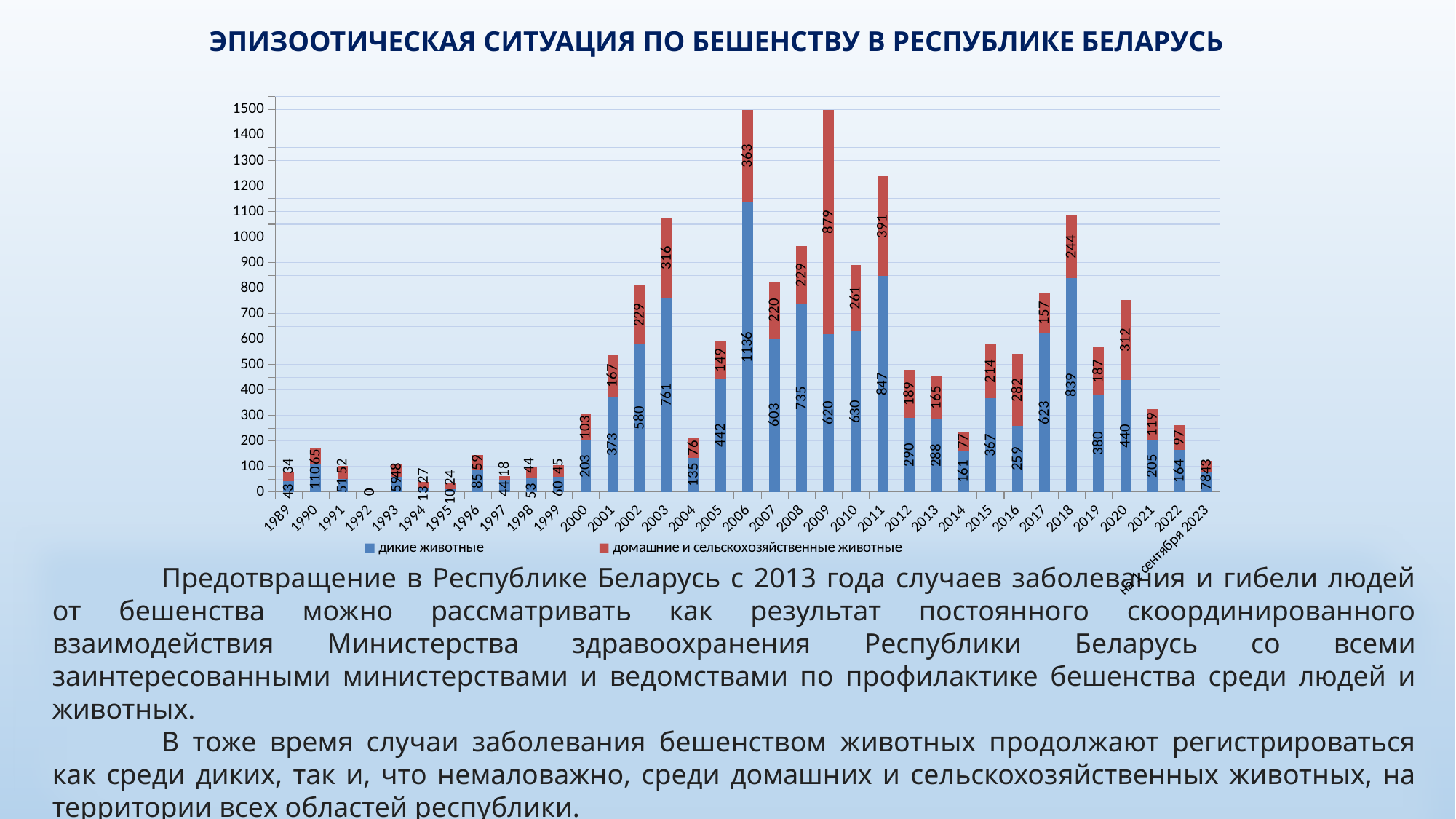
In which year is the value for дикие животные the highest? 2006 What is the title of the slide containing the chart? ЭПИЗООТИЧЕСКАЯ СИТУАЦИЯ ПО БЕШЕНСТВУ В РЕСПУБЛИКЕ БЕЛАРУСЬ How many series does the legend list? 2 What kind of chart is shown on the slide? stacked bar chart What is the total of the stacked bar for 2003? 1077 In 2016, which series has the larger value: дикие животные or домашние и сельскохозяйственные животные? домашние и сельскохозяйственные животные What is the difference between дикие животные and домашние и сельскохозяйственные животные in 2018? 595 What is the value for домашние и сельскохозяйственные животные in 2009? 879 In which year is the value for домашние и сельскохозяйственные животные the highest? 2009 Does the value for дикие животные rise or fall from 2000 to 2003? rise What is the value for дикие животные in 2006? 1136 Is the total of the stacked bar for 2009 greater or less than 1400? greater